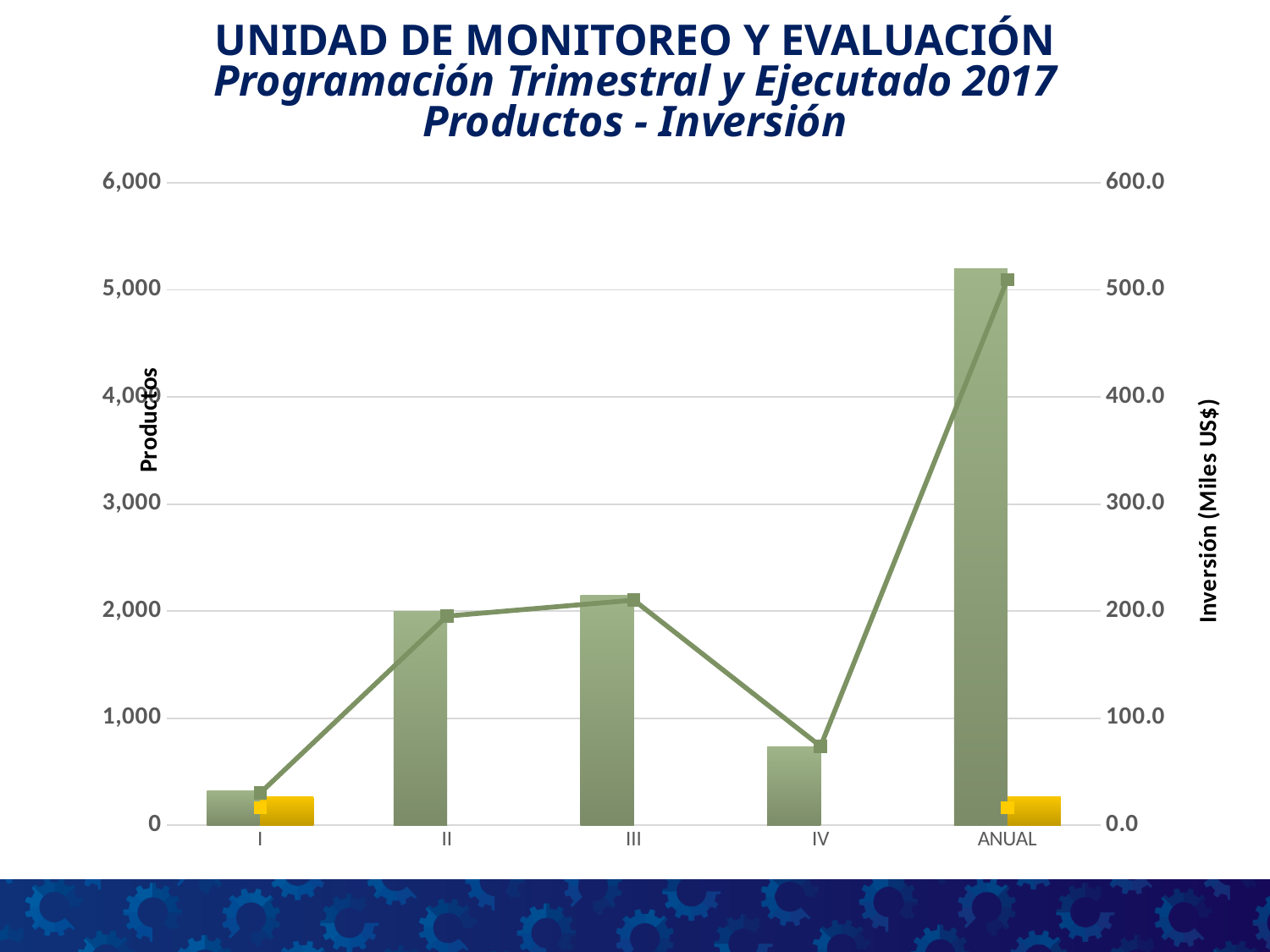
Is the green bar for II greater or less than 1,000 on the Productos axis? greater Which category has the shortest green bar? I Does the line rise or fall from III to IV? fall How many categories are shown on the x axis of the chart? 5 Is the green bar for IV greater or less than 1,000 on the Productos axis? less Is the green bar for ANUAL greater or less than 4,000 on the Productos axis? greater What is the title of the right-hand vertical axis? Inversión (Miles US$) Which category has the tallest green bar? ANUAL What kind of chart is shown on the slide? A combined bar and line chart Which has the taller green bar, II or IV? II